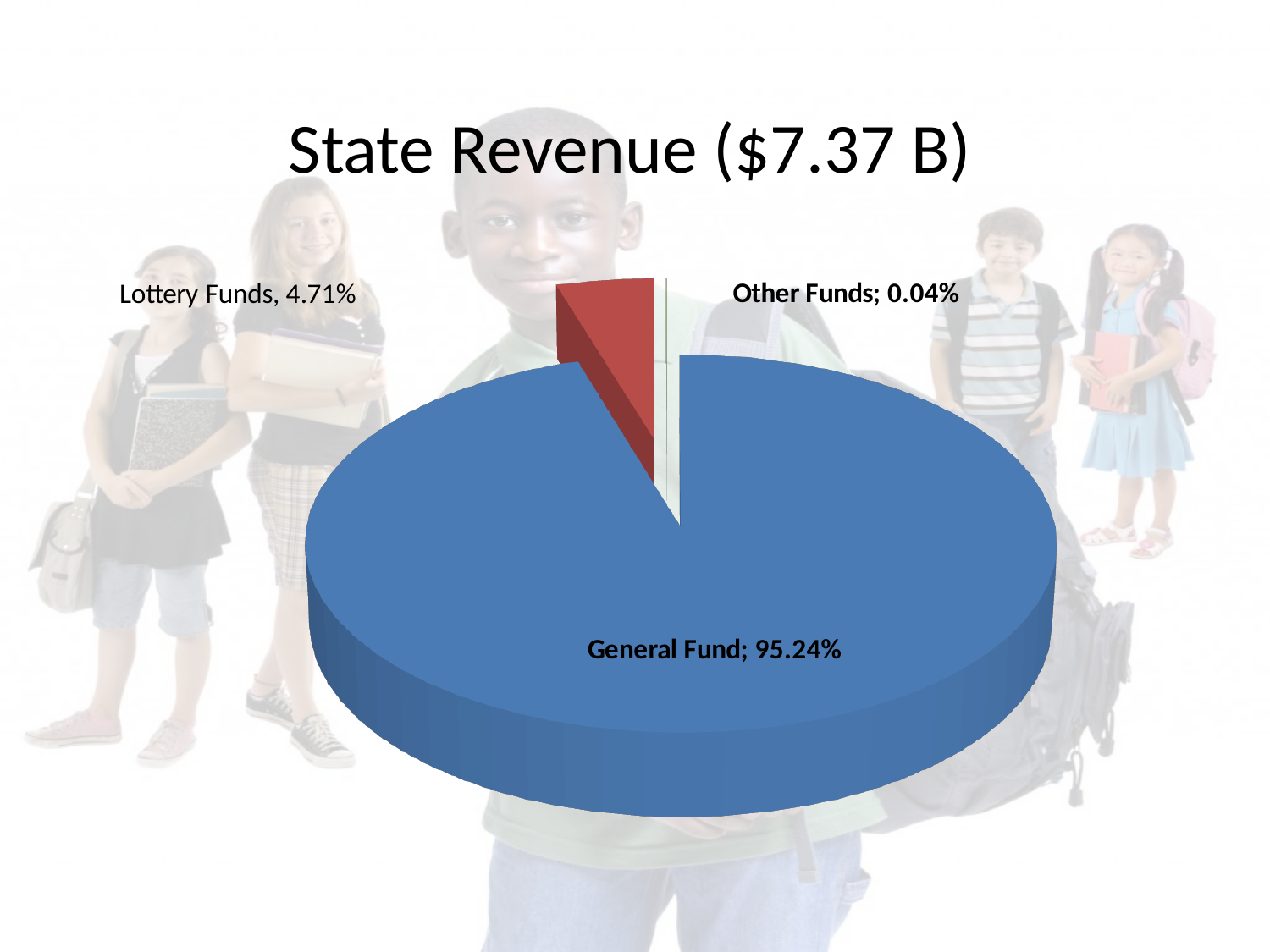
What kind of chart is shown on the slide? Pie chart What share of State Revenue comes from the General Fund? 95.24% What share of State Revenue comes from Lottery Funds? 4.71% What is the difference in percentage points between the General Fund share and the Lottery Funds share? 90.53 Which revenue source has the largest share of State Revenue? General Fund Which is larger, the Lottery Funds share or the Other Funds share? Lottery Funds What share of State Revenue comes from Other Funds? 0.04% What is the title of the chart? State Revenue ($7.37 B) What is the difference in percentage points between the Lottery Funds share and the Other Funds share? 4.67 What colour is the General Fund slice? Blue Which revenue source has the smallest share of State Revenue? Other Funds How many revenue sources are shown in the pie chart? 3